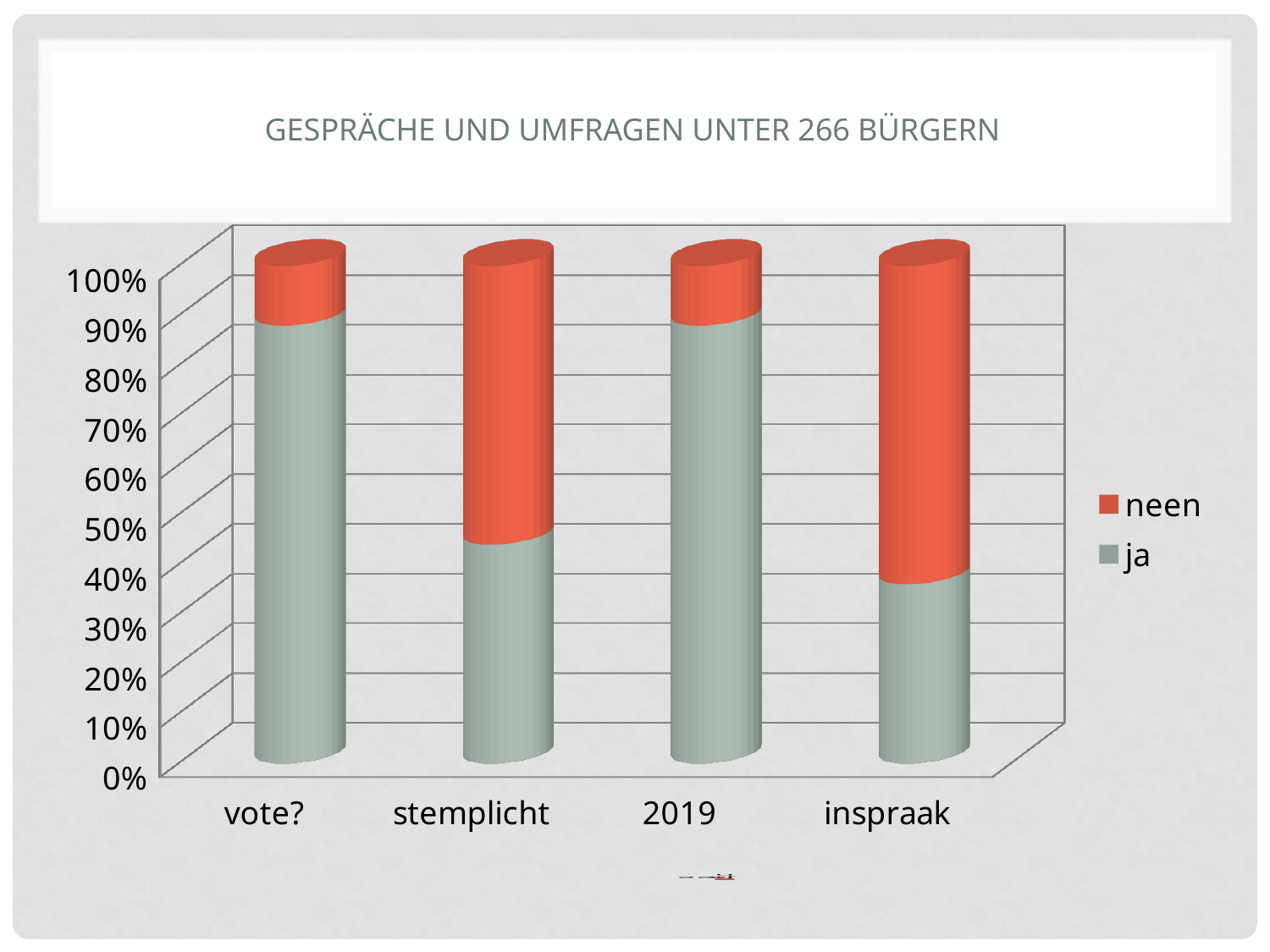
What kind of chart is shown on the slide? Stacked bar chart Which category has the smallest 'ja' share? inspraak Is the 'ja' share for vote? greater or less than 80%? greater Which has the larger 'ja' share, vote? or stemplicht? vote? Which series is shown in red in the chart? neen What is the title of the chart? GESPRÄCHE UND UMFRAGEN UNTER 266 BÜRGERN Which category has the largest 'neen' share? inspraak Is the 'ja' share for inspraak greater or less than 50%? less How many series does the chart's legend list? 2 Which has the larger 'neen' share, 2019 or inspraak? inspraak Is the 'ja' share for stemplicht greater or less than 60%? less How many categories are shown on the x axis of the chart? 4